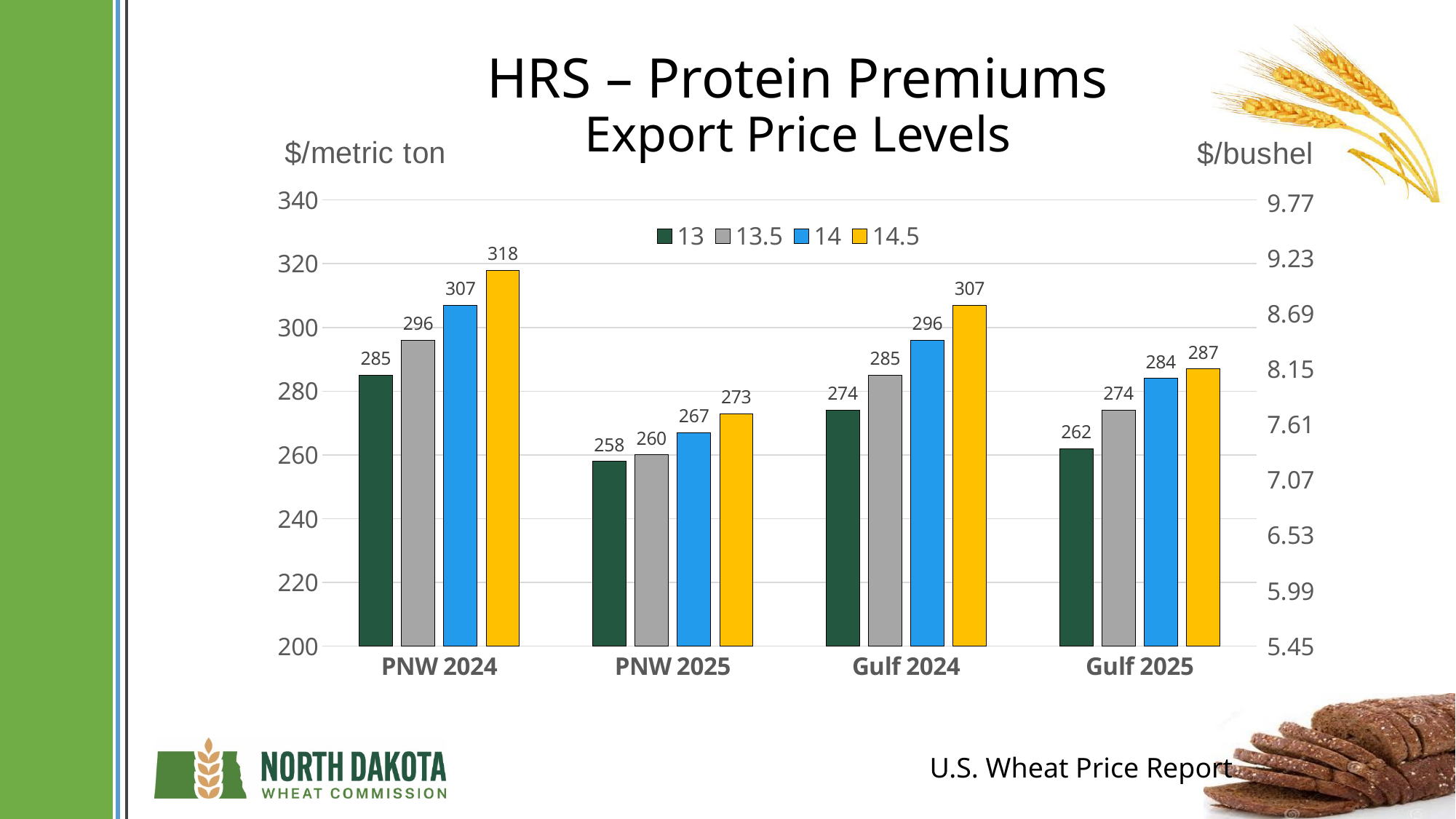
Which category has the highest value for the 13.5 series? PNW 2024 What is the value for the 14 series at PNW 2025? 267 Is the value for the 13 series at PNW 2025 greater or less than 260? less What is the value for the 13 series at Gulf 2025? 262 How many categories are shown on the x axis? 4 Which is larger: the 14 value at Gulf 2024 or the 14 value at Gulf 2025? Gulf 2024 What is the difference between the 14.5 and 13 values at PNW 2024? 33 How many series does the legend list? 4 What unit is shown on the right-hand axis of the chart? $/bushel What is the value for the 14.5 series at PNW 2024? 318 What kind of chart is shown on the slide? bar chart Which category has the lowest value for the 14.5 series? PNW 2025